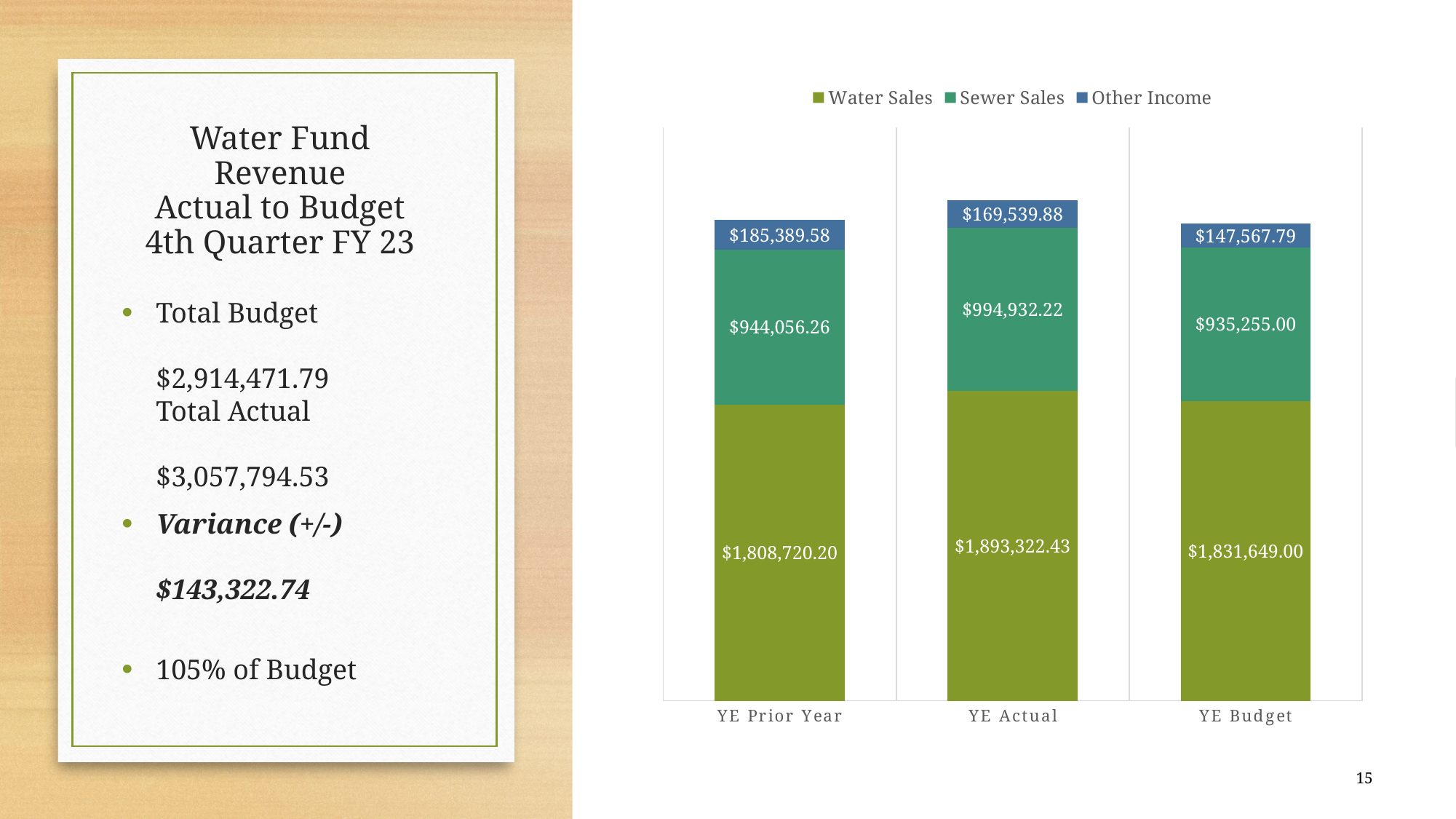
What is the Other Income value for YE Prior Year? $185,389.58 What is the total of the YE Actual stacked bar? $3,057,794.53 What type of chart is shown on the slide? Stacked bar chart What is the difference between Water Sales for YE Actual and Water Sales for YE Budget? $61,673.43 Which is larger, Sewer Sales for YE Prior Year or Sewer Sales for YE Budget? YE Prior Year How many series does the legend list? 3 Which category has the highest Water Sales value? YE Actual How many categories are shown on the x axis? 3 What is the Water Sales value for YE Actual? $1,893,322.43 What is the Sewer Sales value for YE Budget? $935,255.00 Which series is shown in blue in the legend? Other Income Which category has the lowest Other Income value? YE Budget